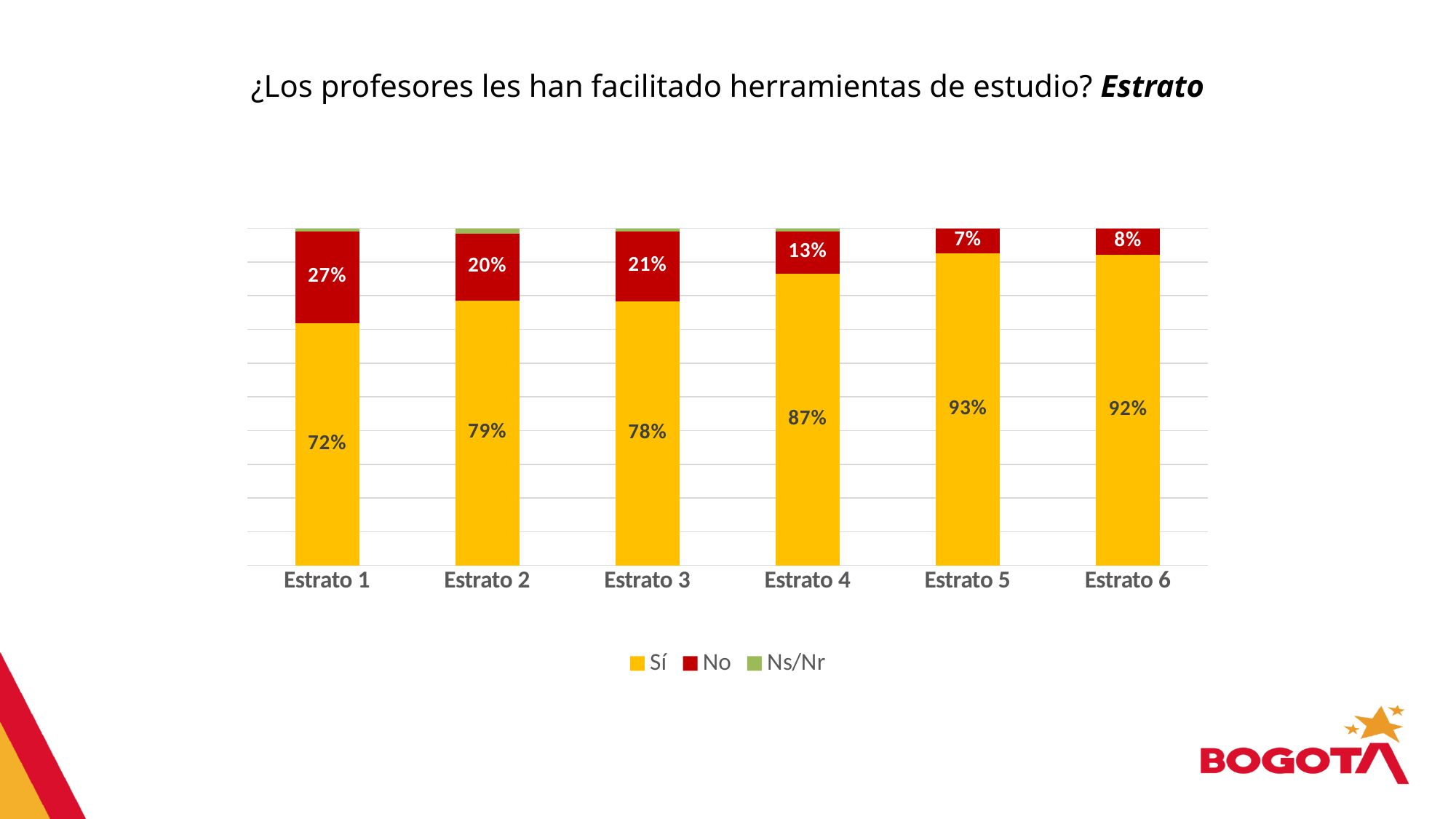
What percentage of Estrato 1 respondents answered "Sí"? 72% What is the difference between the "Sí" values for Estrato 2 and Estrato 1? 7% Which colour represents the "Ns/Nr" series in the legend? Green Which estrato has the highest "Sí" percentage? Estrato 5 Which estrato has the lowest "Sí" percentage? Estrato 1 What kind of chart is shown on the slide? Stacked bar chart How many estrato categories are shown on the x axis? 6 What is the "No" value for Estrato 4? 13% Which is larger, the "No" value for Estrato 2 or for Estrato 3? Estrato 3 What is the "Sí" value for Estrato 5? 93% Which estrato has the highest "No" percentage? Estrato 1 How many series does the legend list? 3